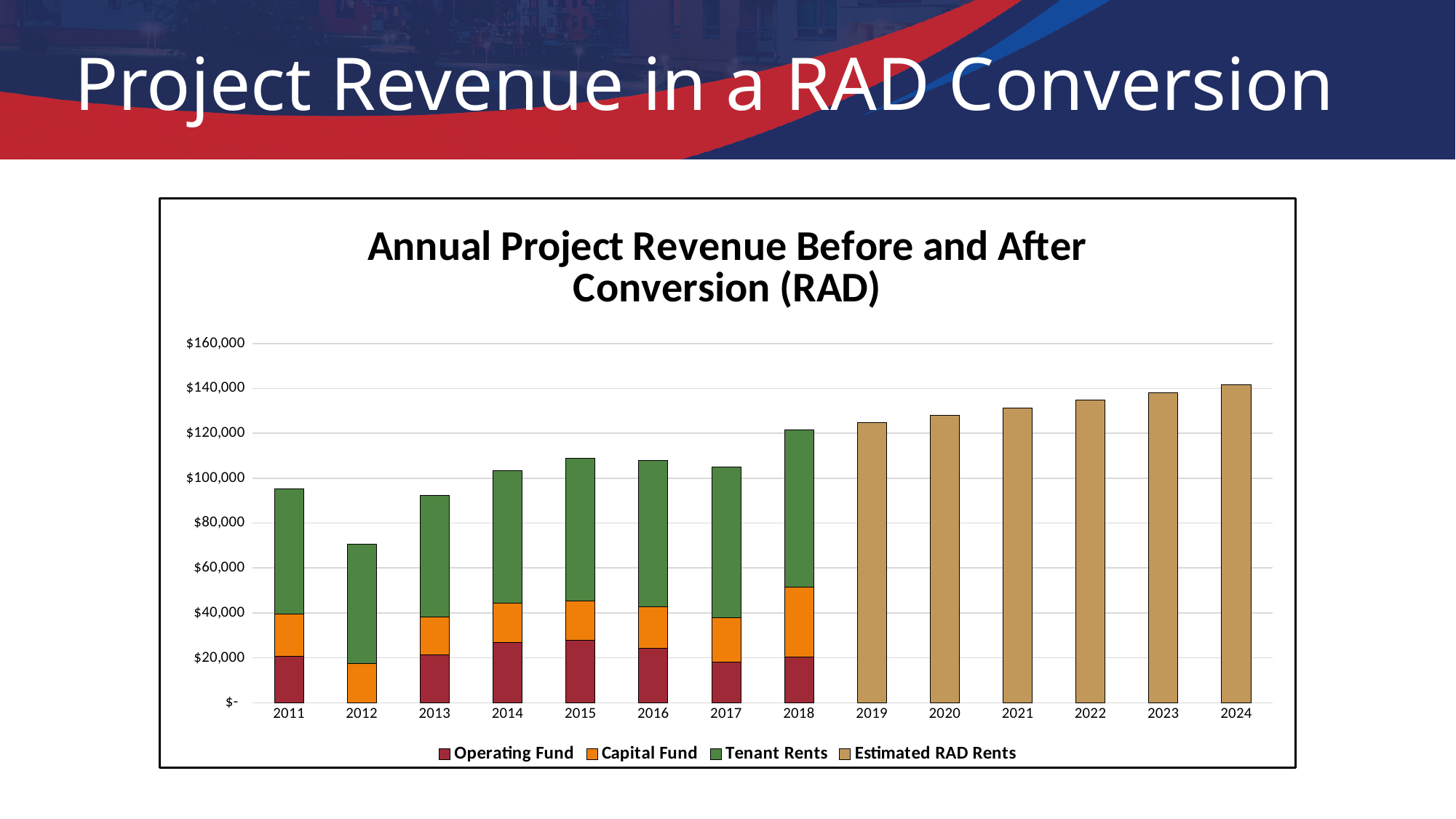
Is the total revenue for 2011 greater or less than $100,000? less Is the total revenue for 2012 greater or less than $80,000? less What is the title of the chart? Annual Project Revenue Before and After Conversion (RAD) Is the total revenue for 2018 greater or less than $100,000? greater How many series does the legend list? 4 What kind of chart is shown on the slide? Bar chart Do the Estimated RAD Rents values rise or fall from 2019 to 2024? rise Which year has the lowest total annual project revenue? 2012 How many years are shown on the x axis? 14 Which year has the larger total revenue, 2011 or 2012? 2011 Which year has the highest total annual project revenue? 2024